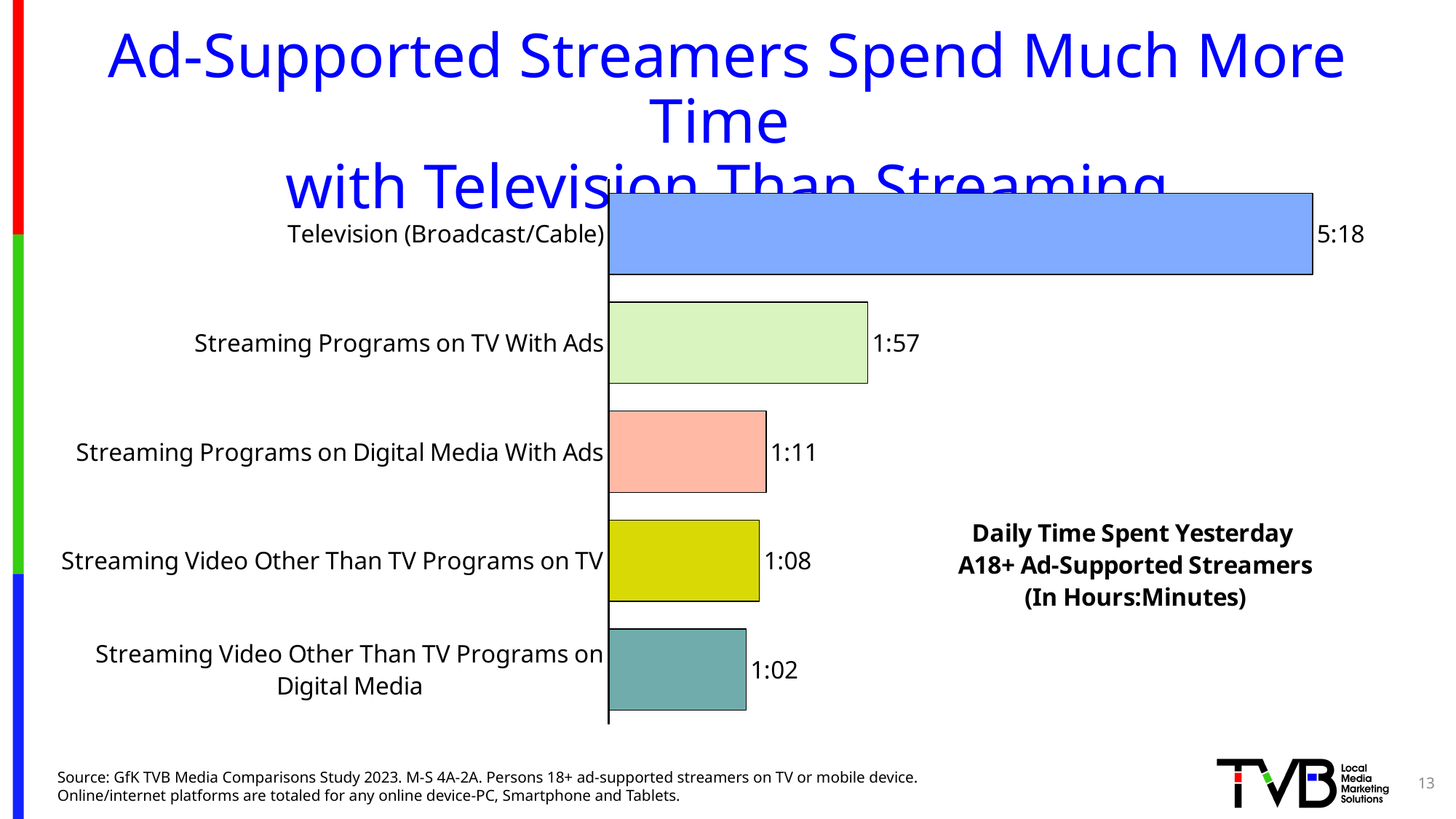
What is the value for Streaming Video Other Than TV Programs on TV? 1:08 How many categories are shown in the chart? 5 In what units are the chart values expressed, according to the chart's label? Hours:Minutes What is the daily time spent for Television (Broadcast/Cable)? 5:18 What is the value for Streaming Video Other Than TV Programs on Digital Media? 1:02 Which category has the highest daily time spent? Television (Broadcast/Cable) Which is larger: the value for Streaming Programs on TV With Ads or for Streaming Programs on Digital Media With Ads? Streaming Programs on TV With Ads What kind of chart is shown on the slide? Bar chart Which category has the lowest daily time spent? Streaming Video Other Than TV Programs on Digital Media What is the value for Streaming Programs on Digital Media With Ads? 1:11 How much more time is spent on Television (Broadcast/Cable) than on Streaming Programs on TV With Ads? 3:21 What is the value for Streaming Programs on TV With Ads? 1:57